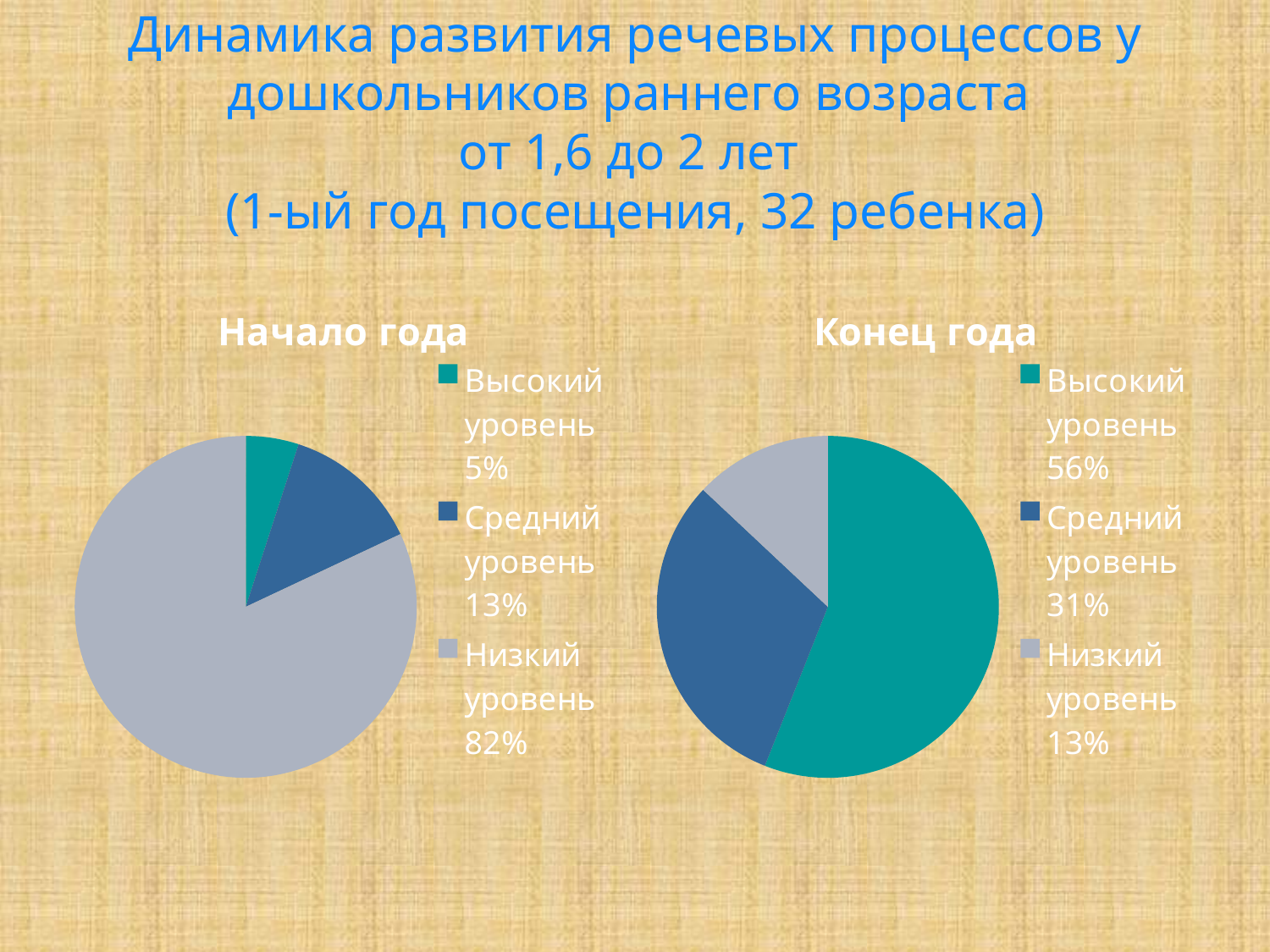
How many categories does the "Конец года" chart show? 3 In the "Конец года" chart, what share does "Средний уровень" have? 31% What kind of chart is the "Начало года" chart? Pie chart In the "Начало года" chart, what share does "Высокий уровень" have? 5% In the "Начало года" chart, which category has the largest slice? Низкий уровень In the "Начало года" chart, which is larger: "Средний уровень" or "Высокий уровень"? Средний уровень In the "Конец года" chart, what share does "Высокий уровень" have? 56% In the "Начало года" chart, what share does "Низкий уровень" have? 82% How many charts are on the slide? 2 In the "Конец года" chart, what colour is the "Высокий уровень" slice? Teal In the "Конец года" chart, what is the difference between "Высокий уровень" and "Средний уровень"? 25% In the "Конец года" chart, which category has the smallest slice? Низкий уровень